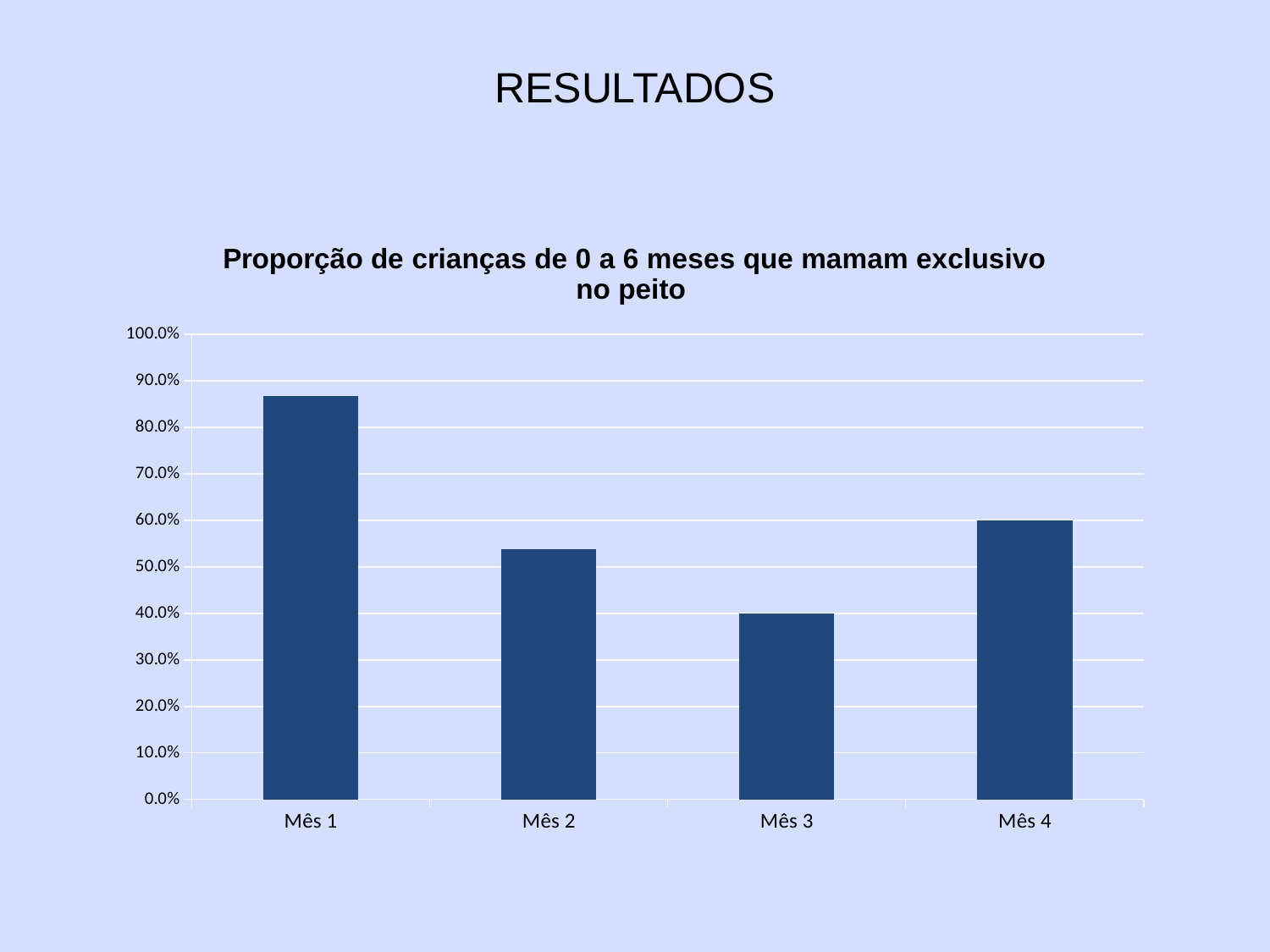
Do the values rise or fall from Mês 1 to Mês 3? fall Which is larger, the value for Mês 1 or the value for Mês 3? Mês 1 Is the value for Mês 2 greater or less than 50.0%? greater What kind of chart is shown on the slide? bar chart Which is larger, the value for Mês 2 or the value for Mês 4? Mês 4 Is the value for Mês 1 greater or less than 80.0%? greater Is the value for Mês 4 greater or less than 70.0%? less How many categories (months) are shown on the x axis of the chart? 4 What is the title of the chart? Proporção de crianças de 0 a 6 meses que mamam exclusivo no peito Which month has the highest proportion of children exclusively breastfed? Mês 1 Which month has the lowest proportion of children exclusively breastfed? Mês 3